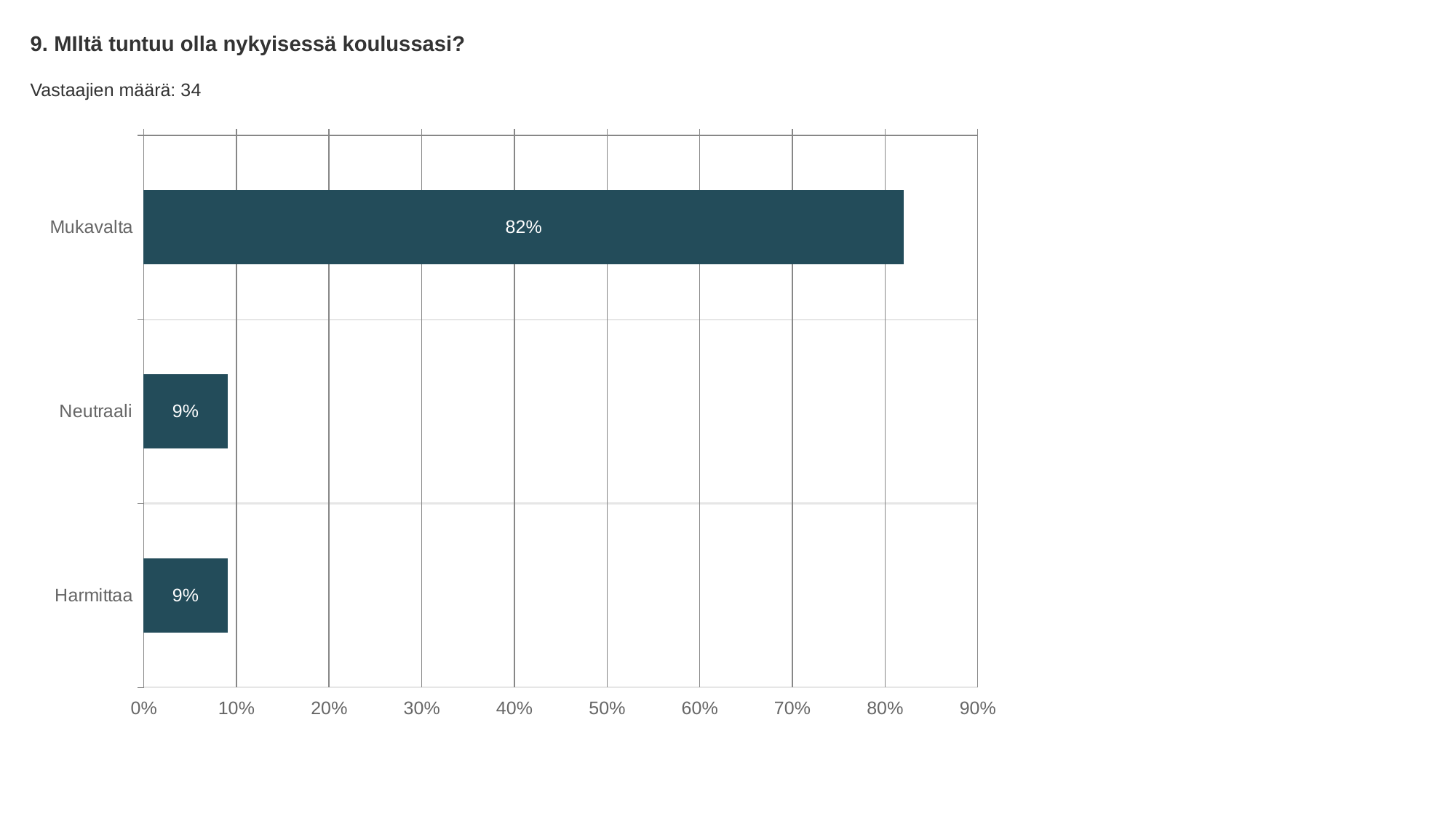
What is the value for Mukavalta? 82% Which is larger, the value for Mukavalta or the value for Harmittaa? Mukavalta What kind of chart is shown on the slide? bar chart Which category has the highest value? Mukavalta Is the value for Neutraali greater or less than 10%? less What is the value for Harmittaa? 9% What is the difference between the values for Mukavalta and Neutraali? 73% Is the value for Mukavalta greater or less than 80%? greater What is the title of the chart? 9. MIltä tuntuu olla nykyisessä koulussasi? How many respondents (Vastaajien määrä) does the slide report? 34 What is the value for Neutraali? 9% How many categories are shown in the chart? 3